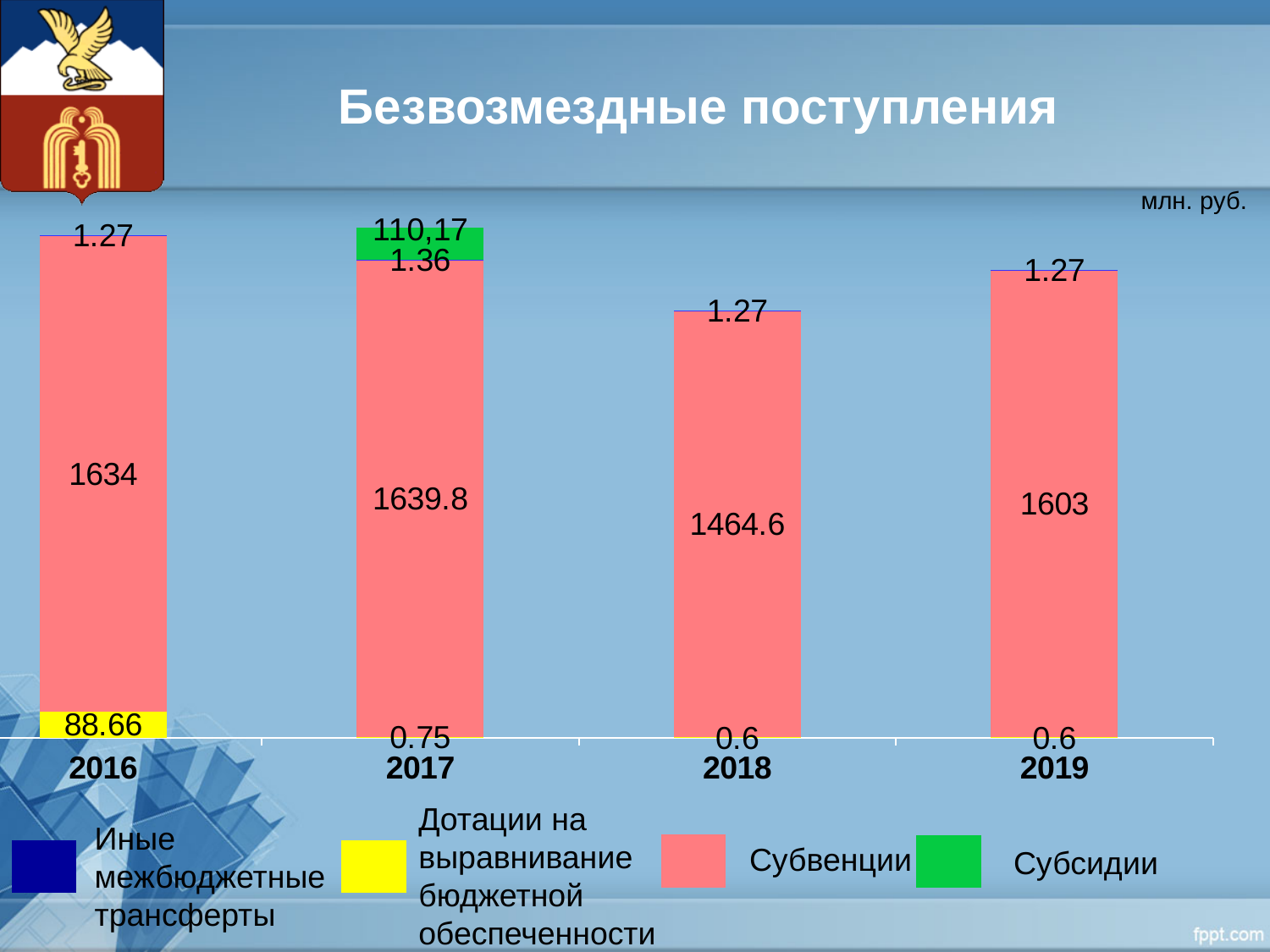
What type of chart is shown on the slide? stacked bar chart What is the value of Субсидии for 2017? 110,17 What is the difference between the Субвенции values for 2016 and 2019? 31 Is the Субвенции value larger in 2019 or in 2018? 2019 Which year has the lowest value for Субвенции? 2018 How many years are shown on the x axis? 4 What is the value of Субвенции for 2017? 1639.8 How many series does the legend list? 4 What is the value of Субвенции for 2018? 1464.6 What is the value of Дотации на выравнивание бюджетной обеспеченности for 2016? 88.66 What is the value of Иные межбюджетные трансферты for 2017? 1.36 Which year has the highest value for Субвенции? 2017